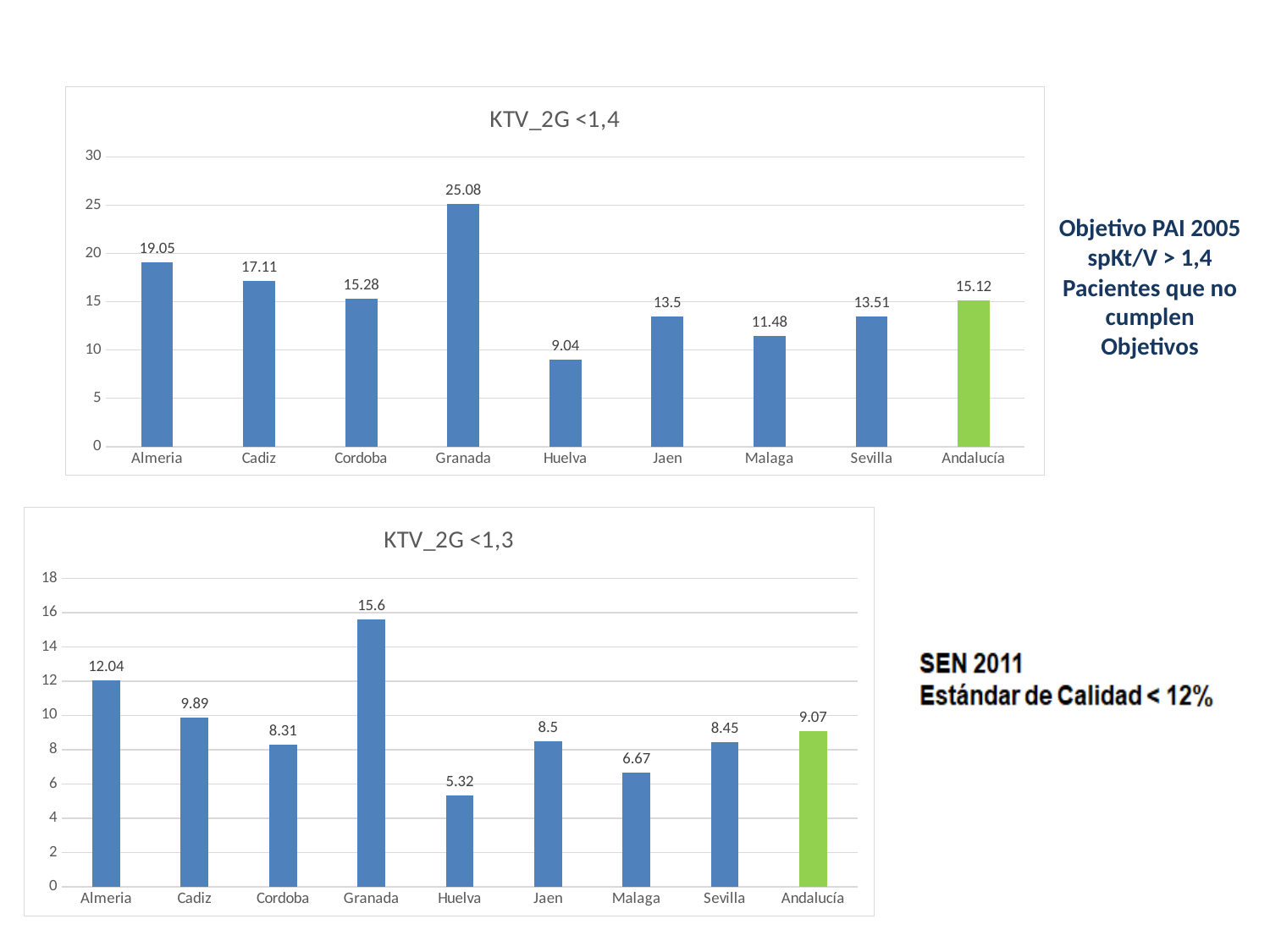
In the chart titled "KTV_2G <1,4", what is the difference between the values for Almeria and Cadiz? 1.94 In the chart titled "KTV_2G <1,3", what is the value for Malaga? 6.67 In the chart titled "KTV_2G <1,4", how many categories are shown on the x axis? 9 In the chart titled "KTV_2G <1,4", which category has the lowest value? Huelva In the chart titled "KTV_2G <1,3", what is the difference between the values for Granada and Andalucía? 6.53 In the chart titled "KTV_2G <1,4", what is the value for Andalucía? 15.12 In the chart titled "KTV_2G <1,3", which category has the highest value? Granada In the chart titled "KTV_2G <1,3", which is larger, the value for Cadiz or the value for Cordoba? Cadiz In the chart titled "KTV_2G <1,3", what is the value for Huelva? 5.32 In the chart titled "KTV_2G <1,4", what is the value for Granada? 25.08 What kind of chart is the chart titled "KTV_2G <1,3"? Bar chart In the chart titled "KTV_2G <1,4", which bar is coloured green instead of blue? Andalucía